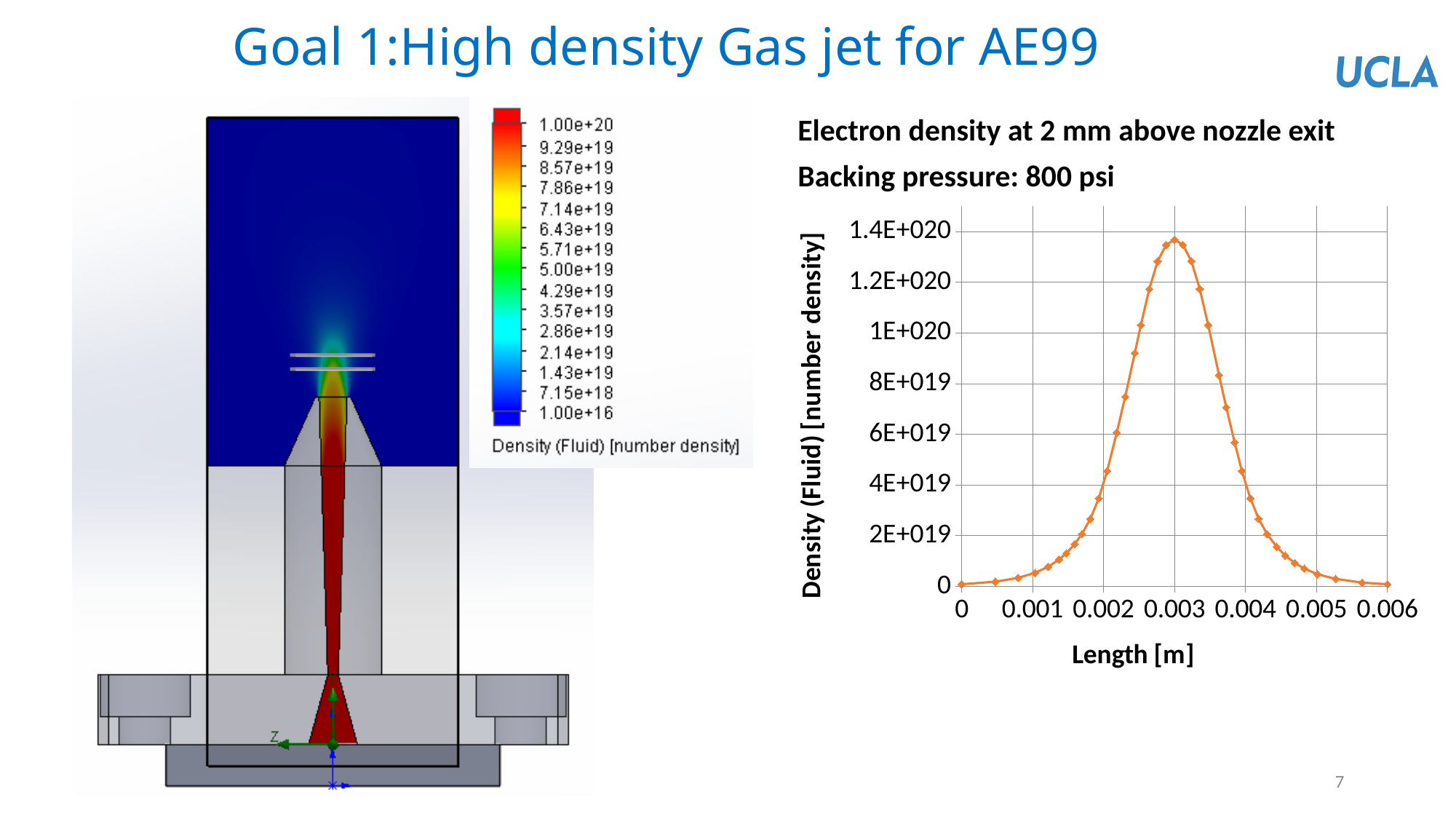
In the chart on the right, what is the title of the x axis? Length [m] In the chart on the right, is the density at a length of 0.003 greater or less than 1.2E+020? greater In the chart on the right, what is the title of the y axis? Density (Fluid) [number density] In the chart on the right, is the density at a length of 0.005 greater or less than 2E+019? less In the chart on the right, does the density rise or fall as the length increases from 0 to 0.003? rise In the chart on the right, is the density at a length of 0.001 greater or less than 2E+019? less In the chart on the right, does the density rise or fall as the length increases from 0.003 to 0.006? fall In the chart on the right, which has the higher density: a length of 0.002 or a length of 0.003? 0.003 In the chart on the right, at which x-axis value does the density reach its peak? 0.003 What kind of chart is shown on the right side of the slide? line chart